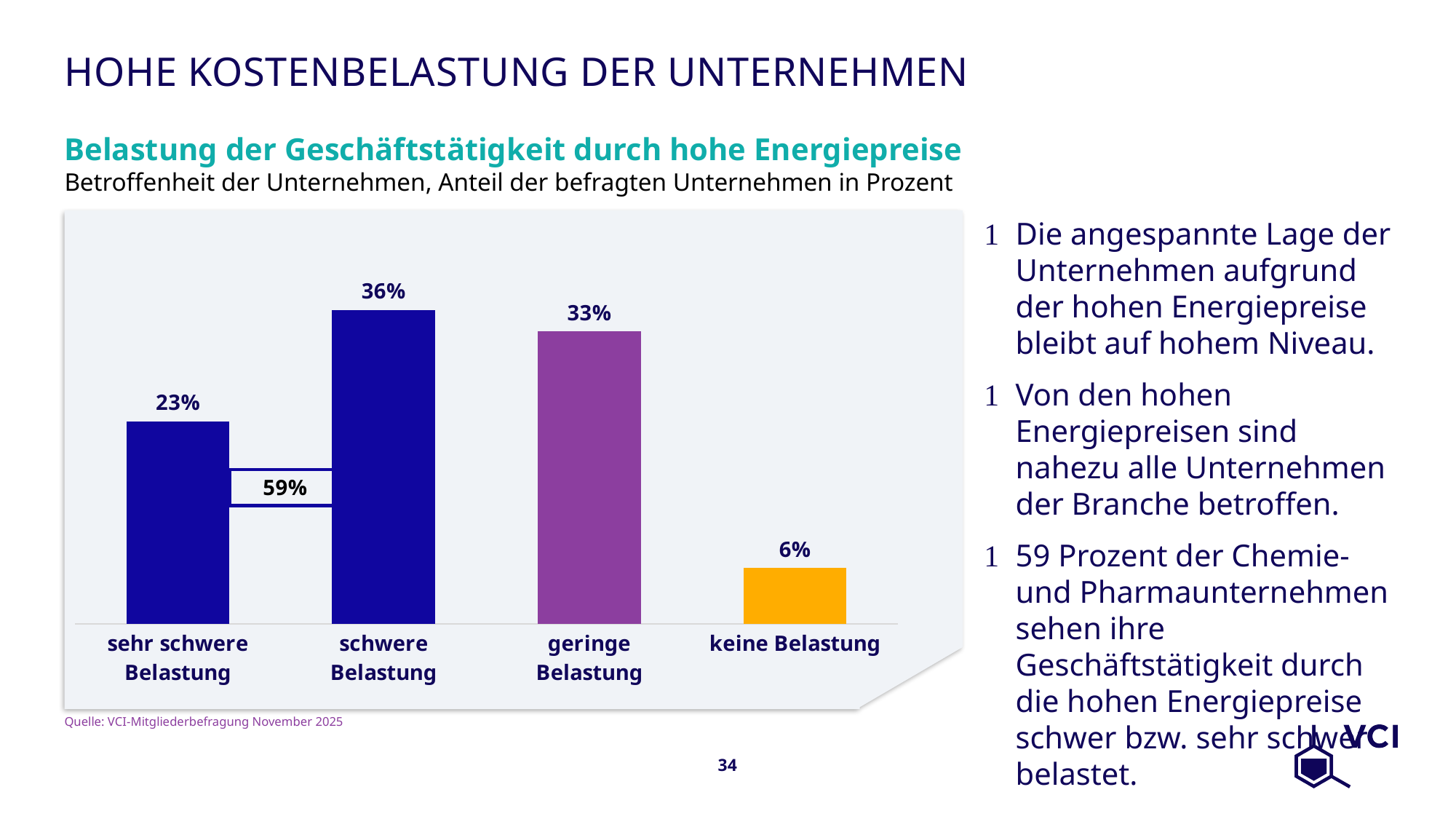
How many categories are shown in the chart? 4 What is the title of the chart? Belastung der Geschäftstätigkeit durch hohe Energiepreise What is the value for "geringe Belastung"? 33% What is the value for "keine Belastung"? 6% What is the value for "schwere Belastung"? 36% What kind of chart is shown on the slide? bar chart What combined value is shown in the bracket linking "sehr schwere Belastung" and "schwere Belastung"? 59% What is the difference between "schwere Belastung" and "sehr schwere Belastung"? 13% Which category has the lowest value? keine Belastung Which category has the highest value? schwere Belastung Which is larger, "geringe Belastung" or "keine Belastung"? geringe Belastung What is the value for "sehr schwere Belastung"? 23%